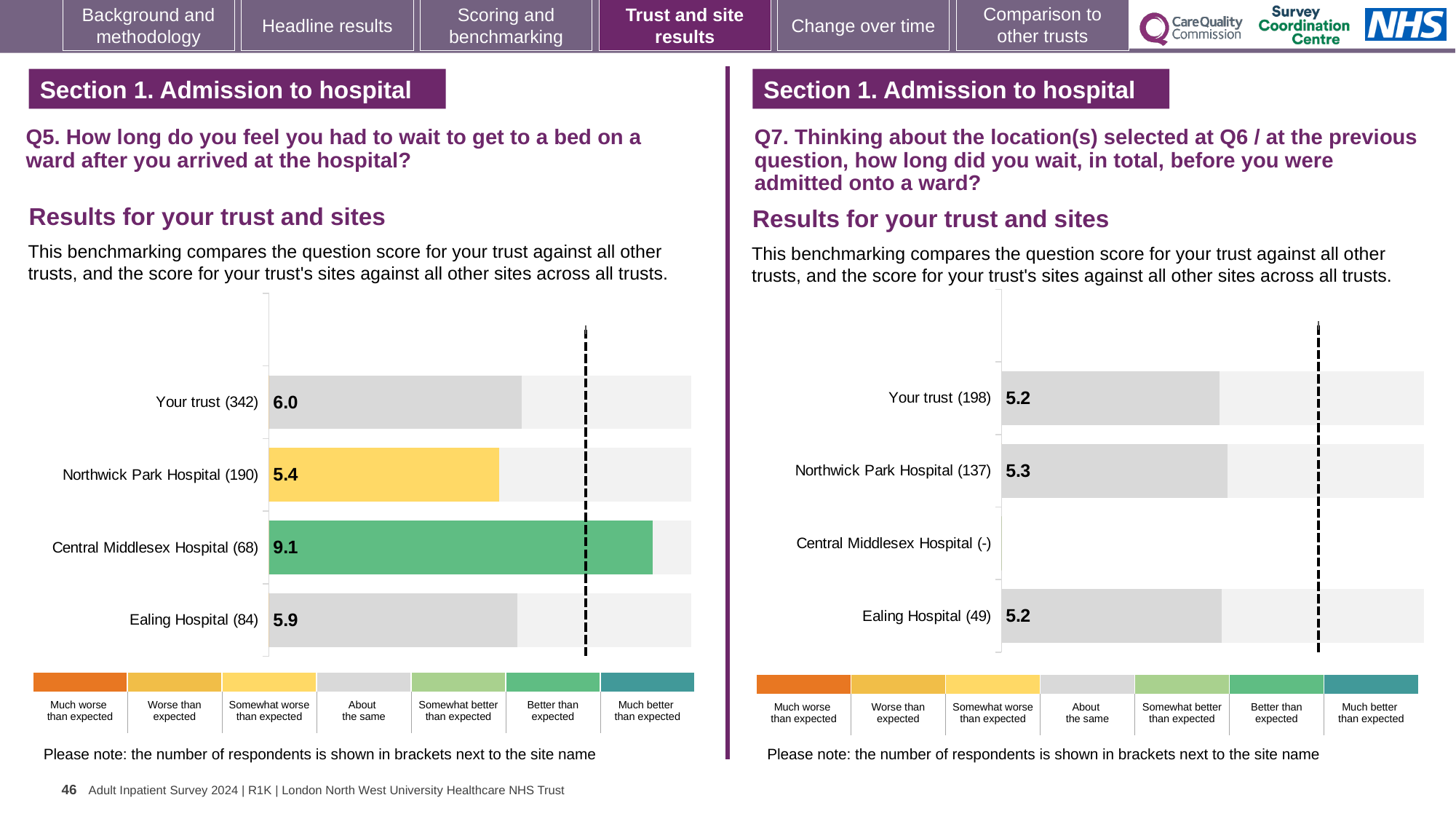
On the Q5 chart (left), which site or trust has the lowest score? Northwick Park Hospital On the Q7 chart (right), what is the score for Your trust? 5.2 On the Q5 chart (left), what is the score for Northwick Park Hospital? 5.4 On the Q7 chart (right), how many rows (trust and sites) are listed? 4 On the Q7 chart (right), how many respondents are shown for Ealing Hospital? 49 What type of chart is used on the Q5 chart (left)? Bar chart On the Q7 chart (right), what is the score for Northwick Park Hospital? 5.3 On the Q5 chart (left), what is the score for Central Middlesex Hospital? 9.1 On the Q5 chart (left), which has the larger score: Your trust or Ealing Hospital? Your trust On the Q5 chart (left), which site or trust has the highest score? Central Middlesex Hospital On the Q5 chart (left), what colour is the bar for Central Middlesex Hospital? Green On the Q5 chart (left), what is the difference between the scores for Central Middlesex Hospital and Ealing Hospital? 3.2